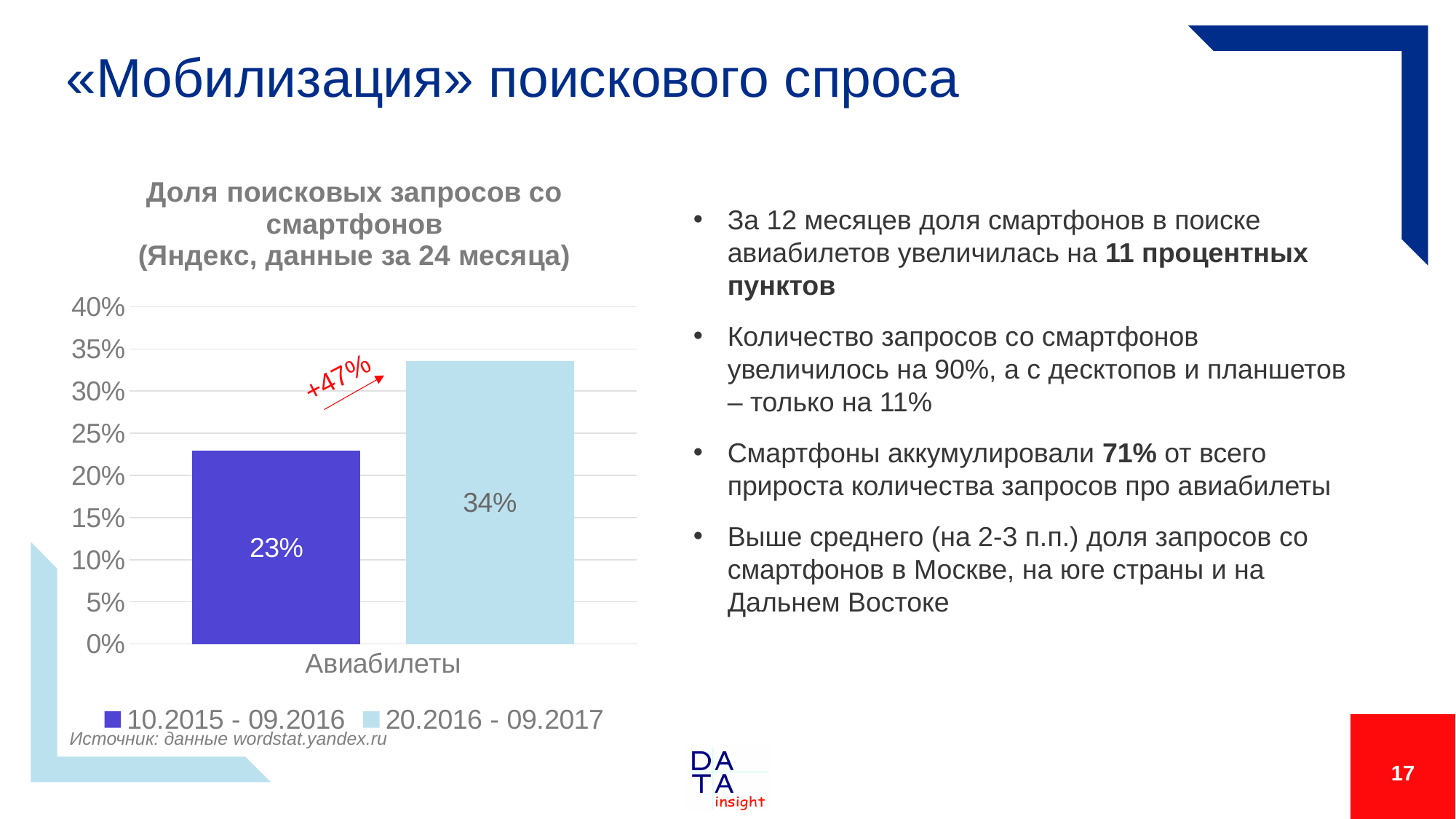
What percentage change is written in red above the bars? +47% How many series does the legend list? 2 What is the category label on the x axis? Авиабилеты How many categories are shown on the x axis? 1 What type of chart is shown on the slide? Bar chart Which series has the higher value for Авиабилеты: 10.2015 - 09.2016 or 20.2016 - 09.2017? 20.2016 - 09.2017 What is the highest value shown on the y axis? 40% What is the difference between the 20.2016 - 09.2017 value and the 10.2015 - 09.2016 value for Авиабилеты? 11% What is the value for the 10.2015 - 09.2016 series for Авиабилеты? 23% What is the value for the 20.2016 - 09.2017 series for Авиабилеты? 34% Is the value for the 10.2015 - 09.2016 series greater or less than 25%? less Is the value for the 20.2016 - 09.2017 series greater or less than 30%? greater